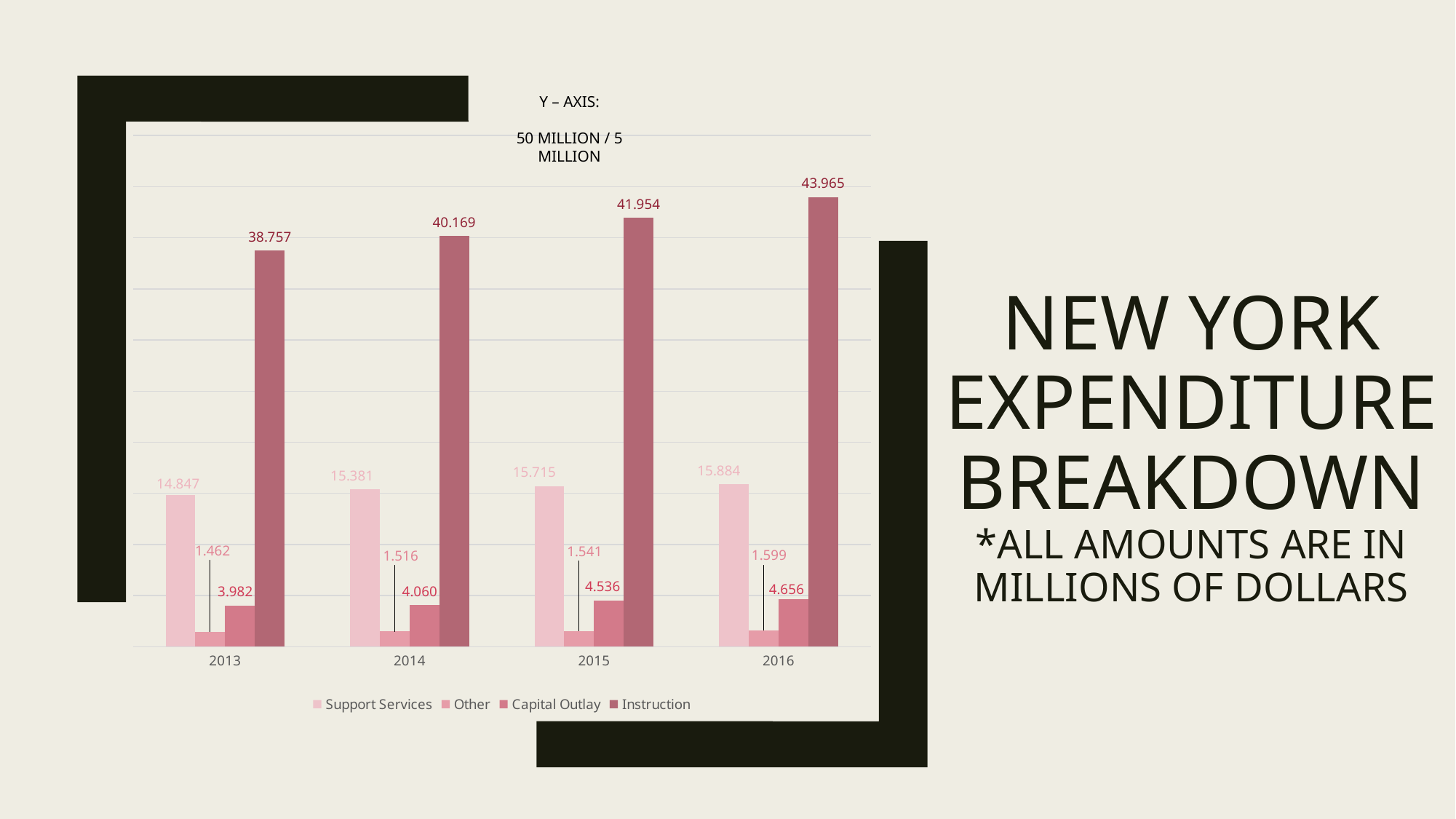
How many years are shown on the x axis? 4 What is the value for Instruction in 2016? 43.965 What is the value for Capital Outlay in 2015? 4.536 Which is larger, Support Services in 2015 or Support Services in 2014? Support Services in 2015 What kind of chart is shown on the slide? Bar chart How many series does the legend list? 4 What is the value for Other in 2014? 1.516 Which year has the highest Instruction value? 2016 What is the value for Support Services in 2013? 14.847 What is the difference between the Instruction values for 2016 and 2013? 5.208 Which series has the lowest value in 2013? Other Do the Capital Outlay values rise or fall from 2013 to 2016? Rise